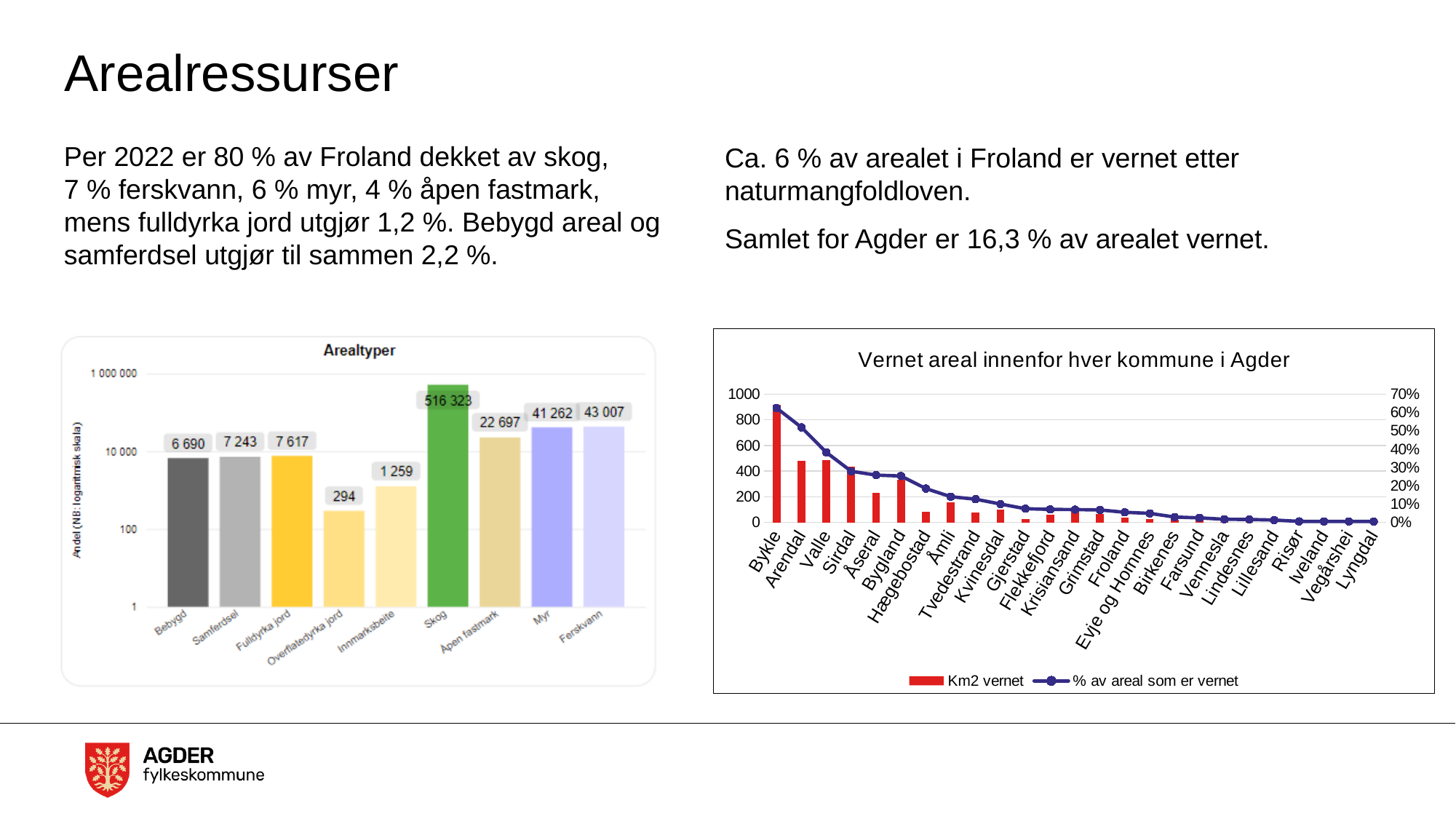
In the chart 'Vernet areal innenfor hver kommune i Agder', is the Km2 vernet value for Bykle greater or less than 800? greater In the Arealtyper chart, what is the value for Ferskvann? 43 007 How many series does the legend list in the chart 'Vernet areal innenfor hver kommune i Agder'? 2 In the Arealtyper chart, what is the value for Skog? 516 323 In the Arealtyper chart, which category has the highest value? Skog In the Arealtyper chart, what is the difference between Ferskvann and Myr? 1 745 In the Arealtyper chart, which category has the lowest value? Overflatedyrka jord In the chart 'Vernet areal innenfor hver kommune i Agder', which municipality has the highest Km2 vernet? Bykle In the Arealtyper chart, what is the value for Overflatedyrka jord? 294 How many categories are shown in the Arealtyper chart? 9 In the chart 'Vernet areal innenfor hver kommune i Agder', does the '% av areal som er vernet' line rise or fall from left to right? fall In the Arealtyper chart, which is larger, Samferdsel or Bebygd? Samferdsel